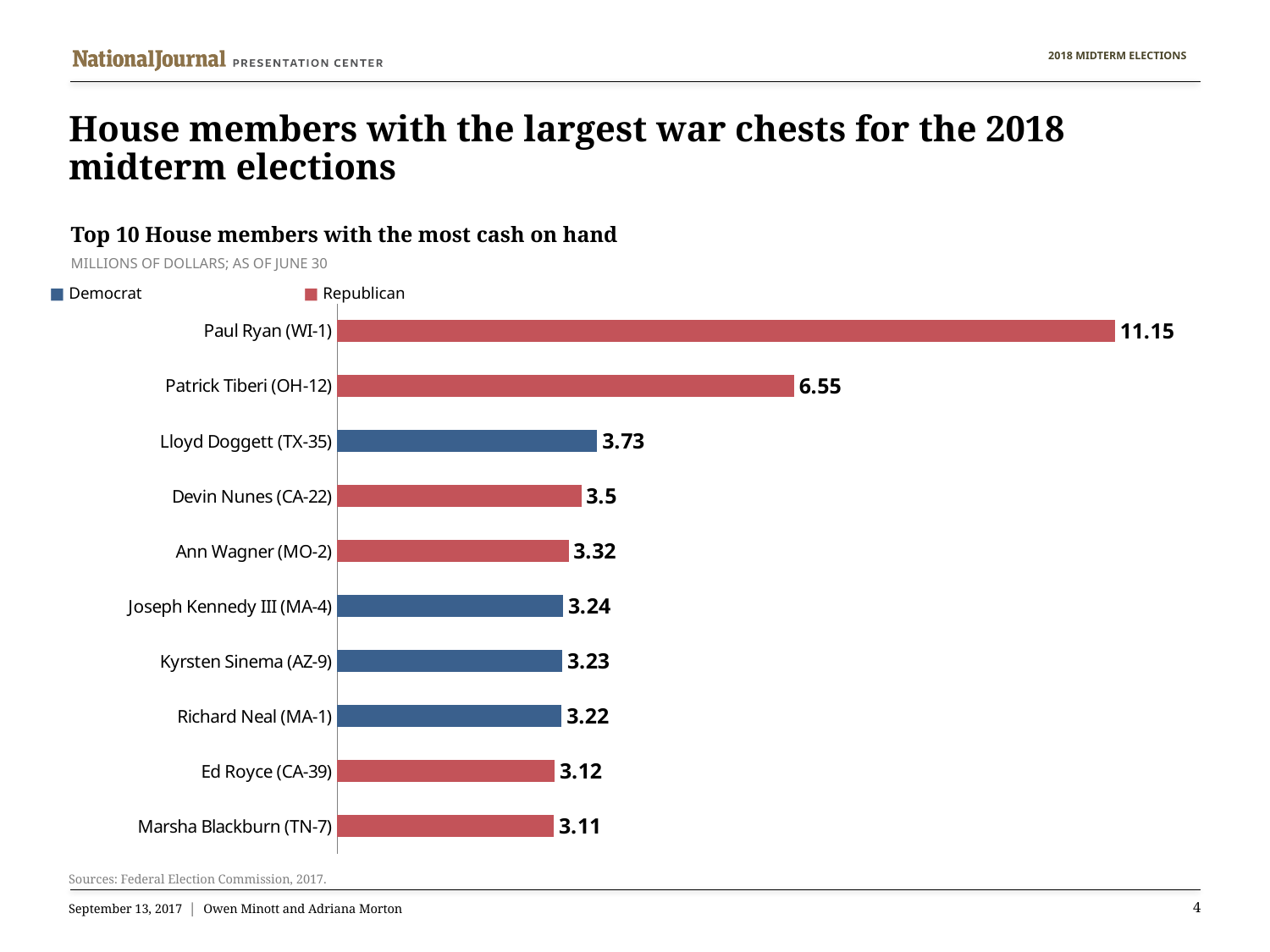
What kind of chart is shown on the slide? Bar chart What is the difference in cash on hand between Lloyd Doggett (TX-35) and Ed Royce (CA-39)? 0.61 What is the cash on hand value for Marsha Blackburn (TN-7)? 3.11 How many House members are shown in the chart? 10 Who has more cash on hand, Devin Nunes (CA-22) or Ann Wagner (MO-2)? Devin Nunes (CA-22) What is the cash on hand value for Paul Ryan (WI-1)? 11.15 What is the difference between Paul Ryan (WI-1) and Patrick Tiberi (OH-12) in cash on hand? 4.6 Which House member has the smallest cash on hand among those shown? Marsha Blackburn (TN-7) Which House member has the largest cash on hand? Paul Ryan (WI-1) Which party does the blue colour represent in the legend? Democrat What is the cash on hand value for Lloyd Doggett (TX-35)? 3.73 How many series does the legend list? 2